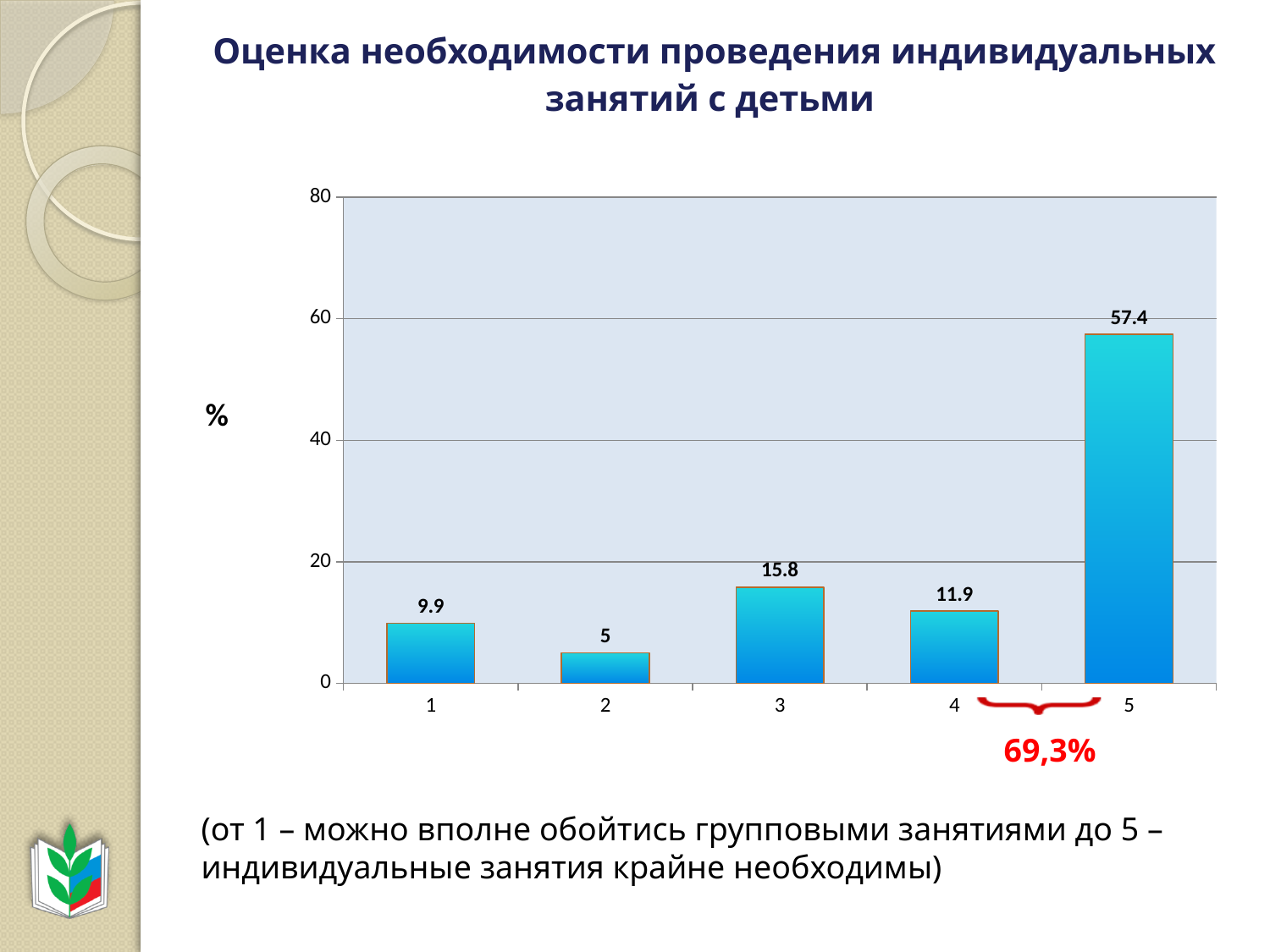
Which category has the lowest value? 2 What is the value for category 5? 57.4 Which is larger, the value for category 3 or the value for category 4? category 3 What label is shown on the vertical axis of the chart? % What is the difference between the values for category 5 and category 3? 41.6 How many categories are shown on the x axis? 5 What is the value for category 1? 9.9 What kind of chart is shown on the slide? bar chart What is the value for category 2? 5 What is the value for category 4? 11.9 What is the value for category 3? 15.8 Which category has the highest value? 5